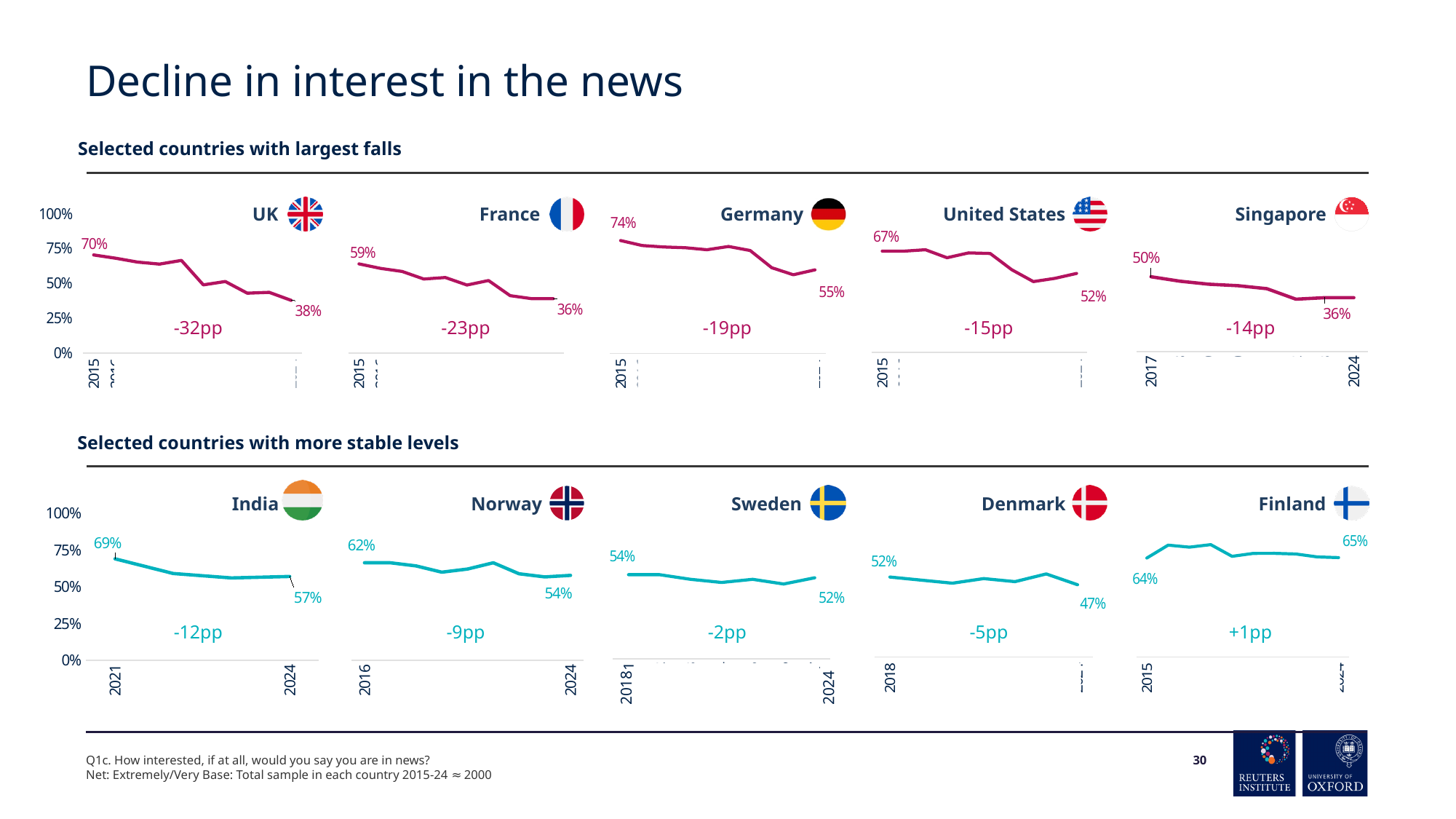
In the Singapore chart, what is the change in percentage points shown between 2017 and 2024? -14pp In the UK chart, what was the value at the end of the series? 38% In the Finland chart, do values rise or fall overall from 2015 to 2024? rise In the India chart, is the 2024 value greater or less than 50%? greater In the France chart, what is the difference between the 2015 value of 59% and the final value of 36%? 23 percentage points In the Germany chart, what was the starting value in 2015? 74% In the UK chart, what was the value at the start of the series in 2015? 70% In the United States chart, do values rise or fall overall from 2015 to 2024? fall What kind of chart is used for each country on this slide? line chart In the Finland chart, what is the final value shown in 2024? 65% Which is larger: the final value in the Denmark chart or the final value in the Sweden chart? Sweden (52%) How many country charts are shown under the heading 'Selected countries with more stable levels'? 5